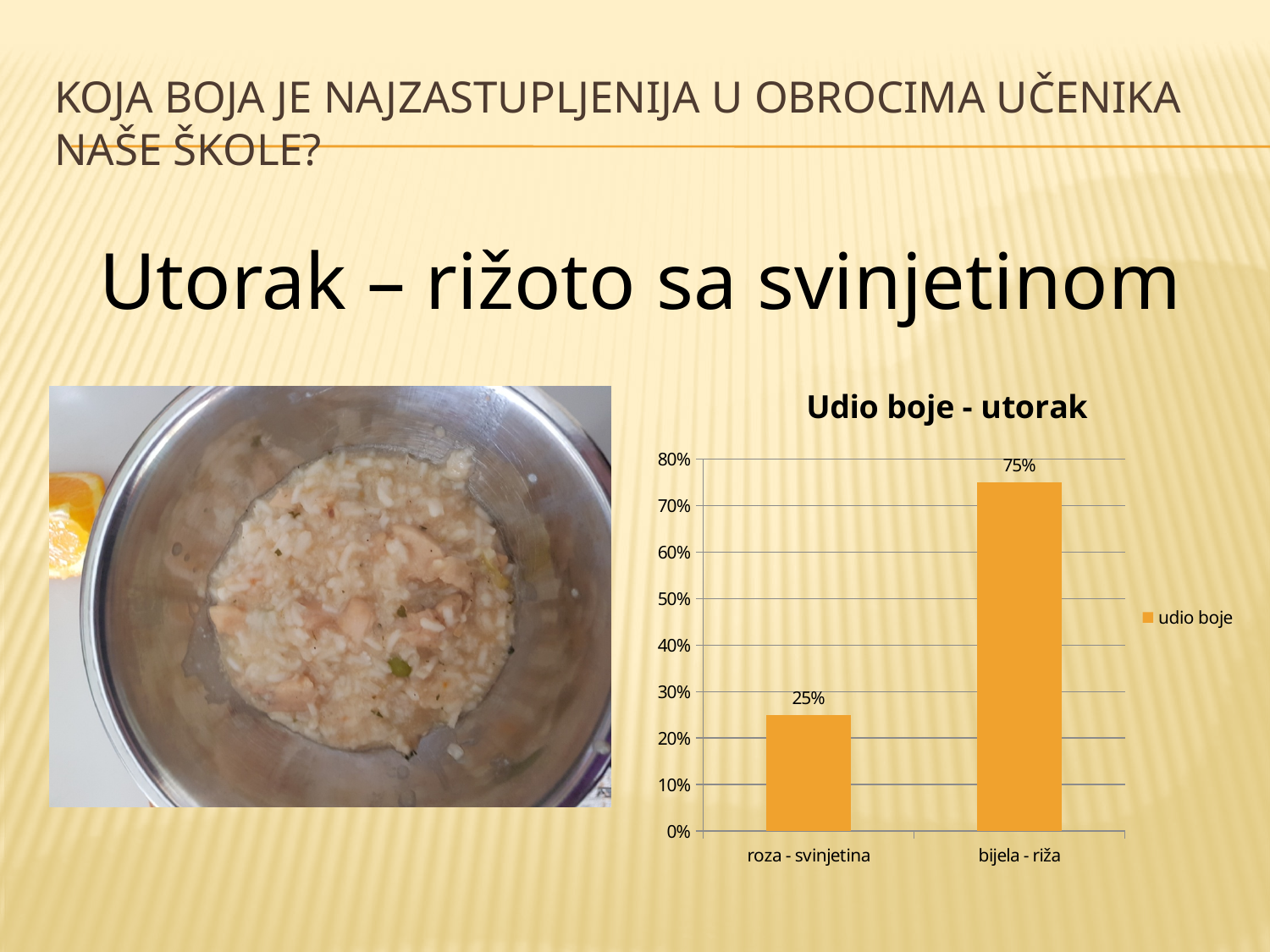
Which category has the highest value? bijela - riža What is the difference between the values for "bijela - riža" and "roza - svinjetina"? 50% What is the title of the chart? Udio boje - utorak Which category has the lowest value? roza - svinjetina How many series does the legend list? 1 What kind of chart is shown? bar chart What is the value for "roza - svinjetina"? 25% Is the value for "bijela - riža" greater or less than 70%? greater How many categories are shown on the x axis? 2 Which is larger, the value for "roza - svinjetina" or the value for "bijela - riža"? bijela - riža Is the value for "roza - svinjetina" greater or less than 30%? less What is the value for "bijela - riža"? 75%